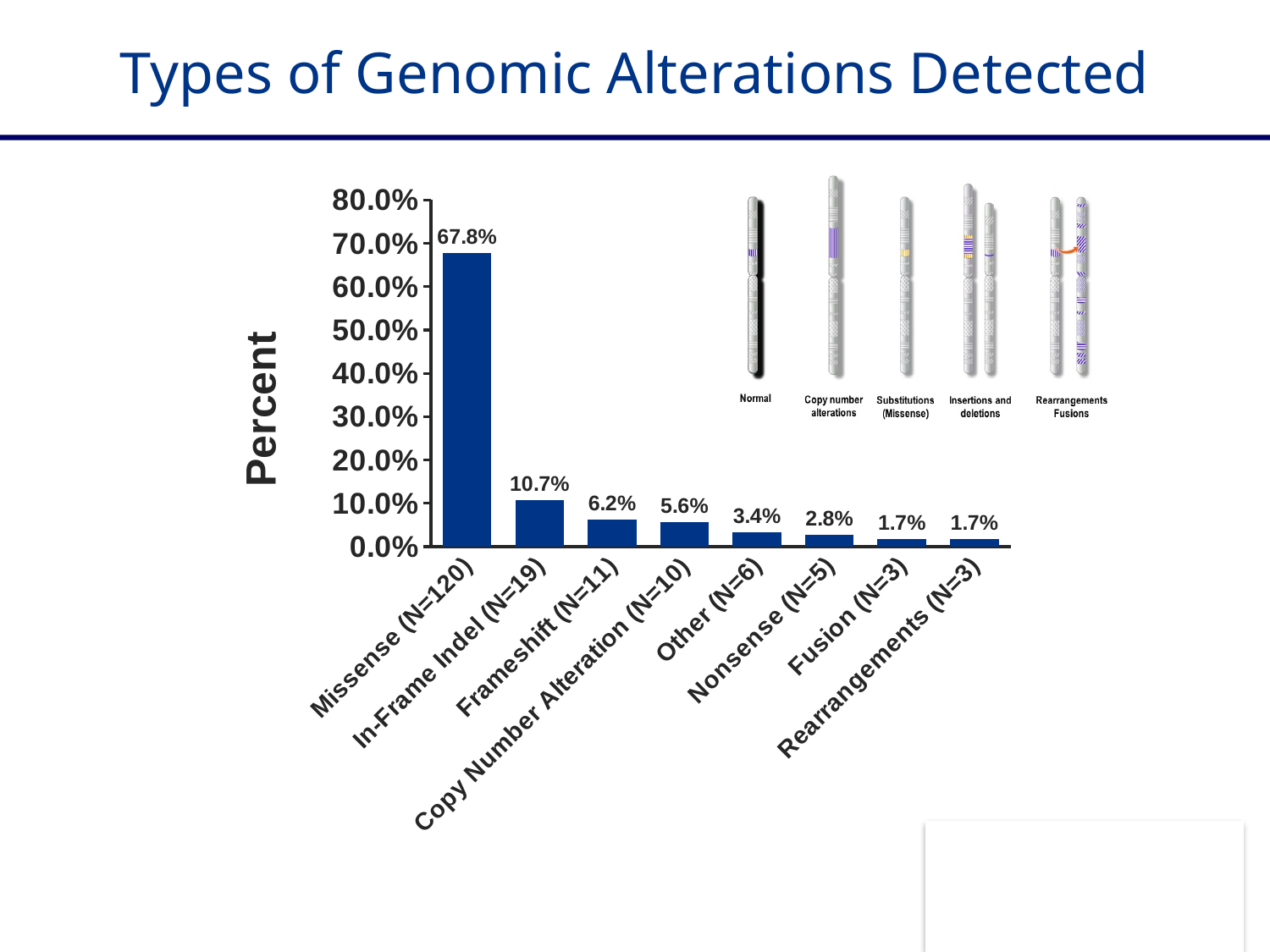
What is the label of the y axis? Percent What is the value for In-Frame Indel (N=19)? 10.7% What kind of chart is shown on the slide? bar chart Is the value for In-Frame Indel (N=19) greater or less than 20.0%? less What is the difference between Frameshift (N=11) and Other (N=6)? 2.8% How many categories are shown on the x axis? 8 What percentage is shown for Missense (N=120)? 67.8% What is the value for Nonsense (N=5)? 2.8% Which is larger, the value for Frameshift (N=11) or Copy Number Alteration (N=10)? Frameshift (N=11) What is the difference between the Missense (N=120) and In-Frame Indel (N=19) percentages? 57.1% Which category has the highest percentage? Missense (N=120) What percentage is shown for Copy Number Alteration (N=10)? 5.6%